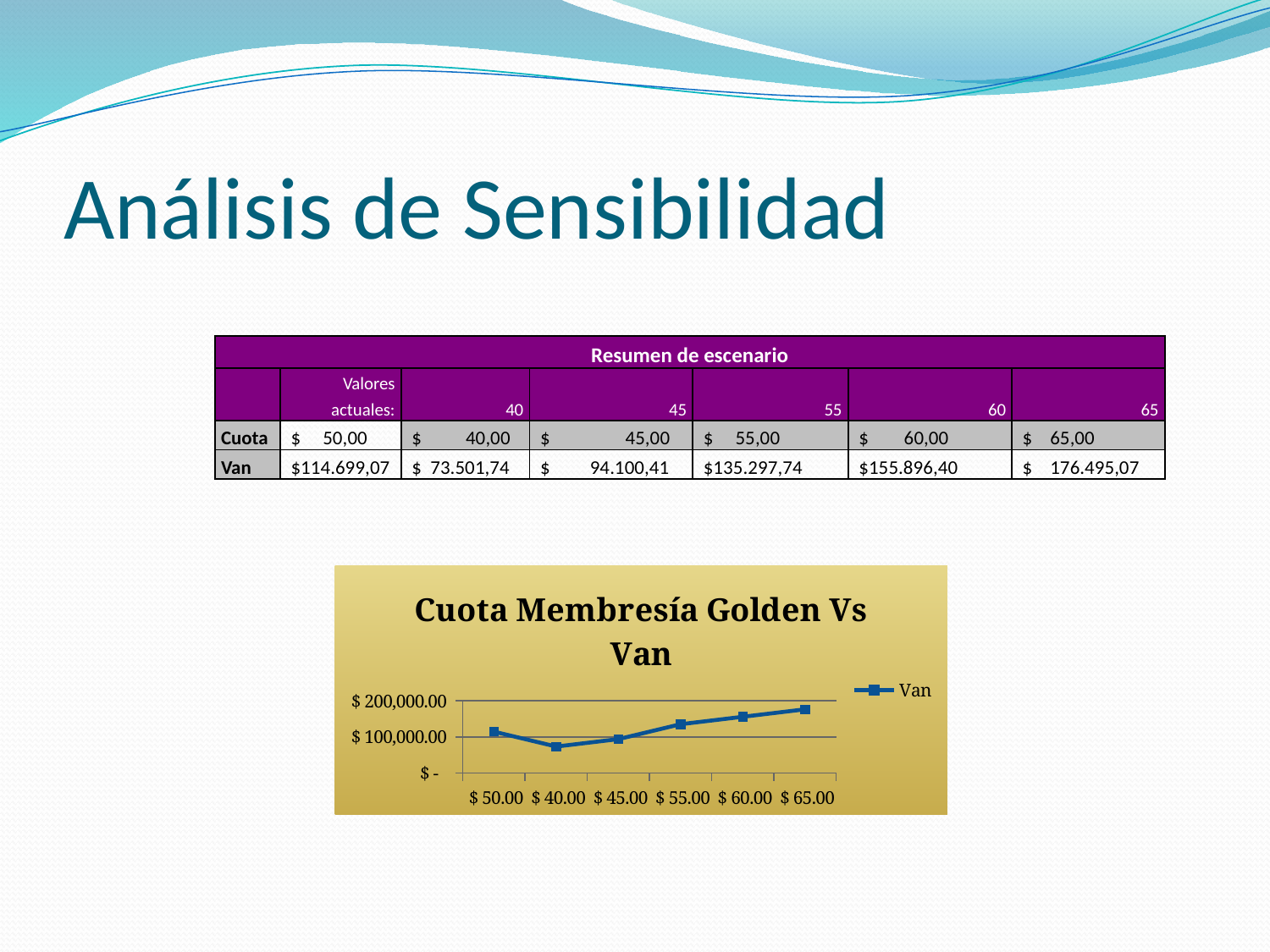
How many data points are plotted in the chart? 6 What is the name of the series shown in the chart legend? Van How many series does the chart legend list? 1 From the $ 40.00 point onward, do the Van values rise or fall along the x axis? rise Is the Van value for $ 65.00 greater or less than $ 200,000.00? less Is the Van value for $ 40.00 greater or less than $ 100,000.00? less What kind of chart is shown on the slide? line chart What is the title of the chart? Cuota Membresía Golden Vs Van Which x-axis category has the highest Van value in the chart? $ 65.00 Which x-axis category has the lowest Van value in the chart? $ 40.00 Is the Van value for $ 65.00 greater or less than $ 100,000.00? greater Which has a larger Van value in the chart, $ 60.00 or $ 40.00? $ 60.00